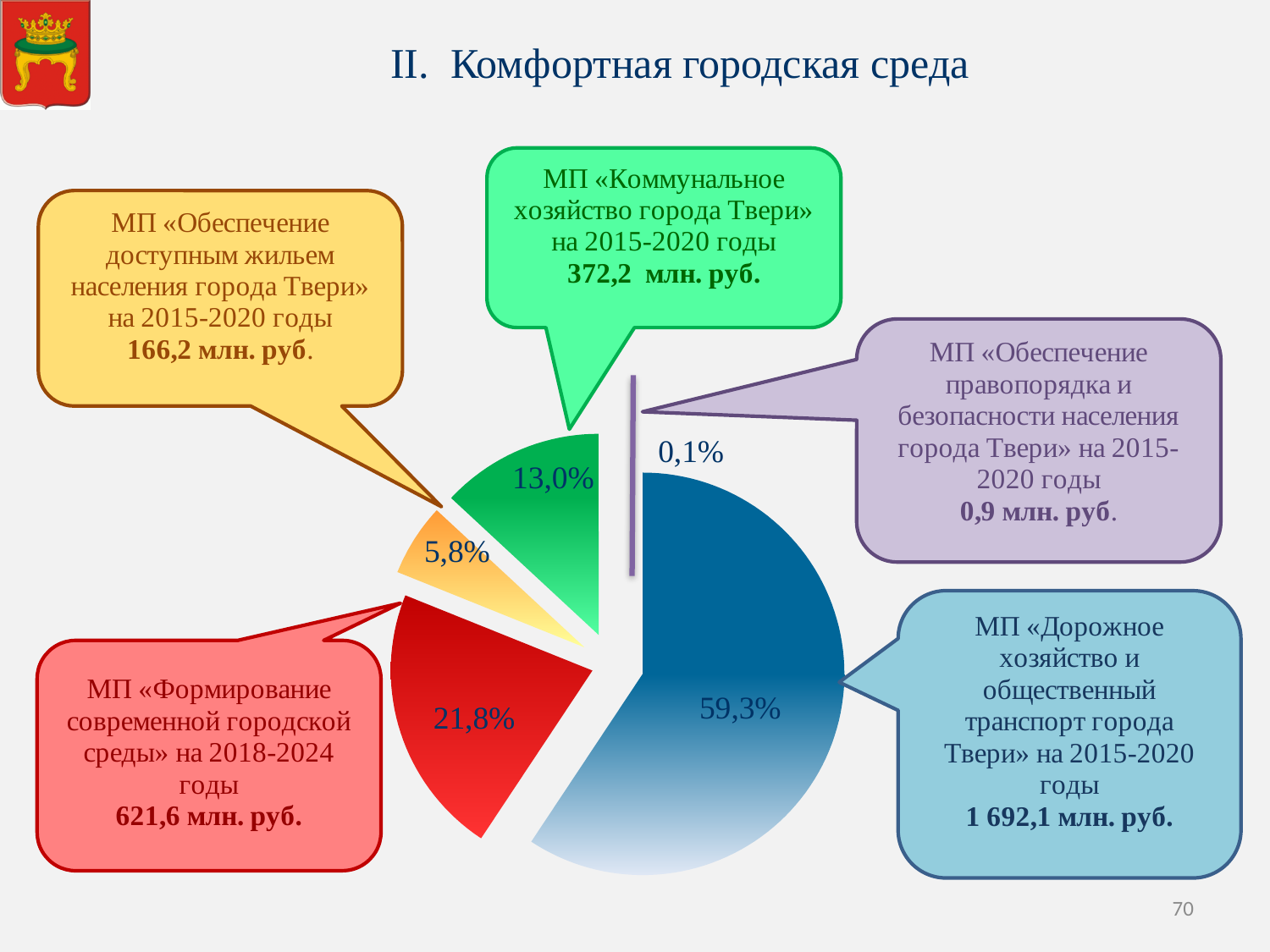
What is the difference in percentage points between the 21,8% slice and the 13,0% slice? 8,8 What kind of chart is shown on the slide? pie chart Which programme has the largest slice of the pie? МП «Дорожное хозяйство и общественный транспорт города Твери» How many slices does the pie chart have? 5 What share of the pie does the slice for МП «Обеспечение правопорядка и безопасности населения города Твери» have? 0,1% Which is larger: the slice for МП «Коммунальное хозяйство города Твери» or the slice for МП «Обеспечение доступным жильем населения города Твери»? МП «Коммунальное хозяйство города Твери» Which programme has the smallest slice of the pie? МП «Обеспечение правопорядка и безопасности населения города Твери» What is the amount in млн. руб. shown for МП «Формирование современной городской среды»? 621,6 млн. руб. What share of the pie does the slice for МП «Коммунальное хозяйство города Твери» have? 13,0% What share of the pie does the slice for МП «Обеспечение доступным жильем населения города Твери» have? 5,8% What share of the pie does the slice for МП «Формирование современной городской среды» have? 21,8% What share of the pie does the slice for МП «Дорожное хозяйство и общественный транспорт города Твери» have? 59,3%